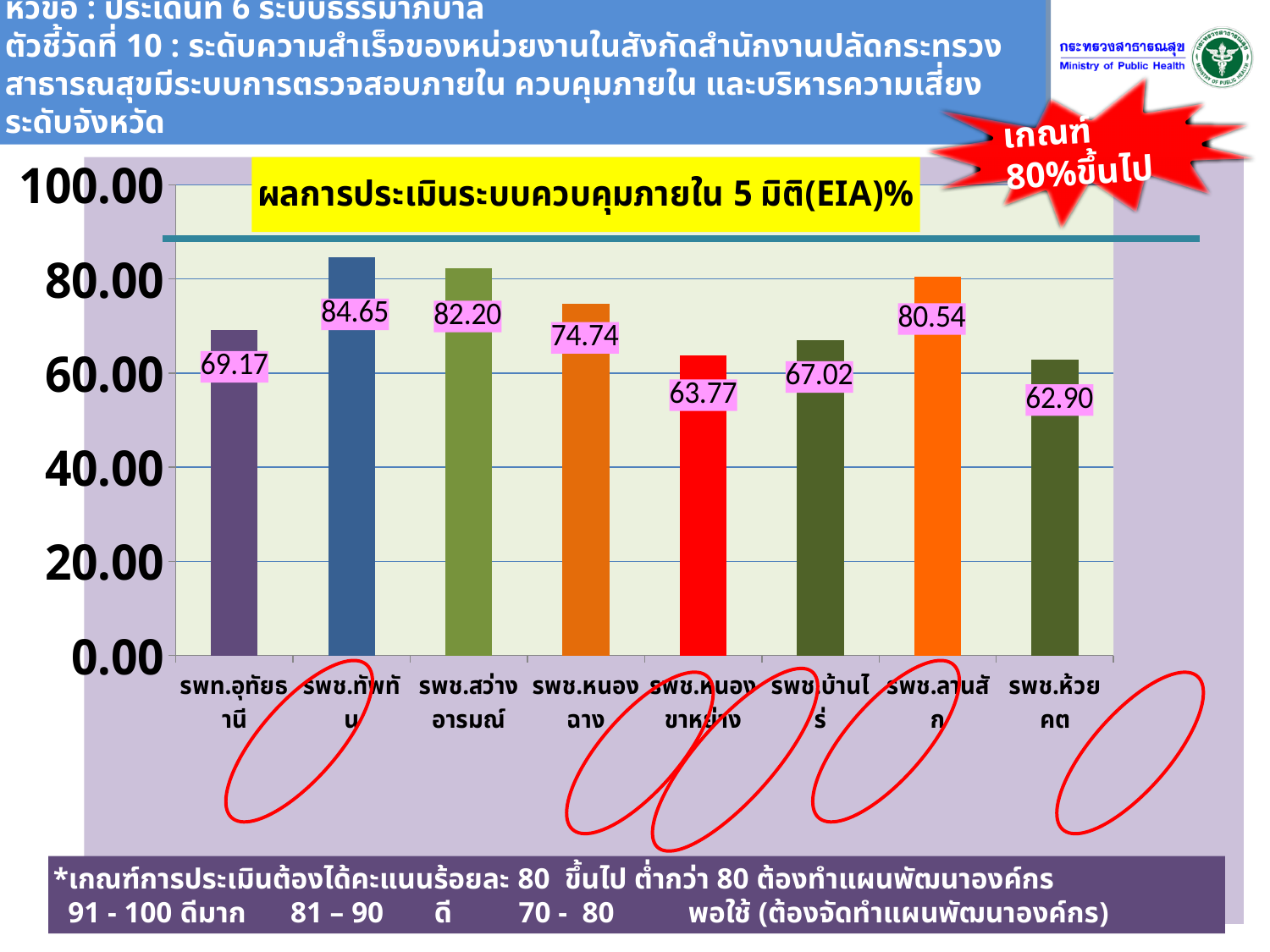
What is the value for รพช.ทัพทัน? 84.65 Which category has the lowest value? รพช.ห้วยคต Is the value for รพช.หนองขาหย่าง greater or less than 80.00? less What is the difference between the values for รพช.ทัพทัน and รพช.ห้วยคต? 21.75 What is the value for รพช.ลานสัก? 80.54 What kind of chart is shown on the slide? bar chart How many categories are shown on the x axis? 8 What is the value for รพช.หนองฉาง? 74.74 Which category has the highest value? รพช.ทัพทัน What is the difference between the values for รพช.สว่างอารมณ์ and รพช.หนองขาหย่าง? 18.43 Which is larger, the value for รพท.อุทัยธานี or the value for รพช.บ้านไร่? รพท.อุทัยธานี What is the title of the chart? ผลการประเมินระบบควบคุมภายใน 5 มิติ(EIA)%